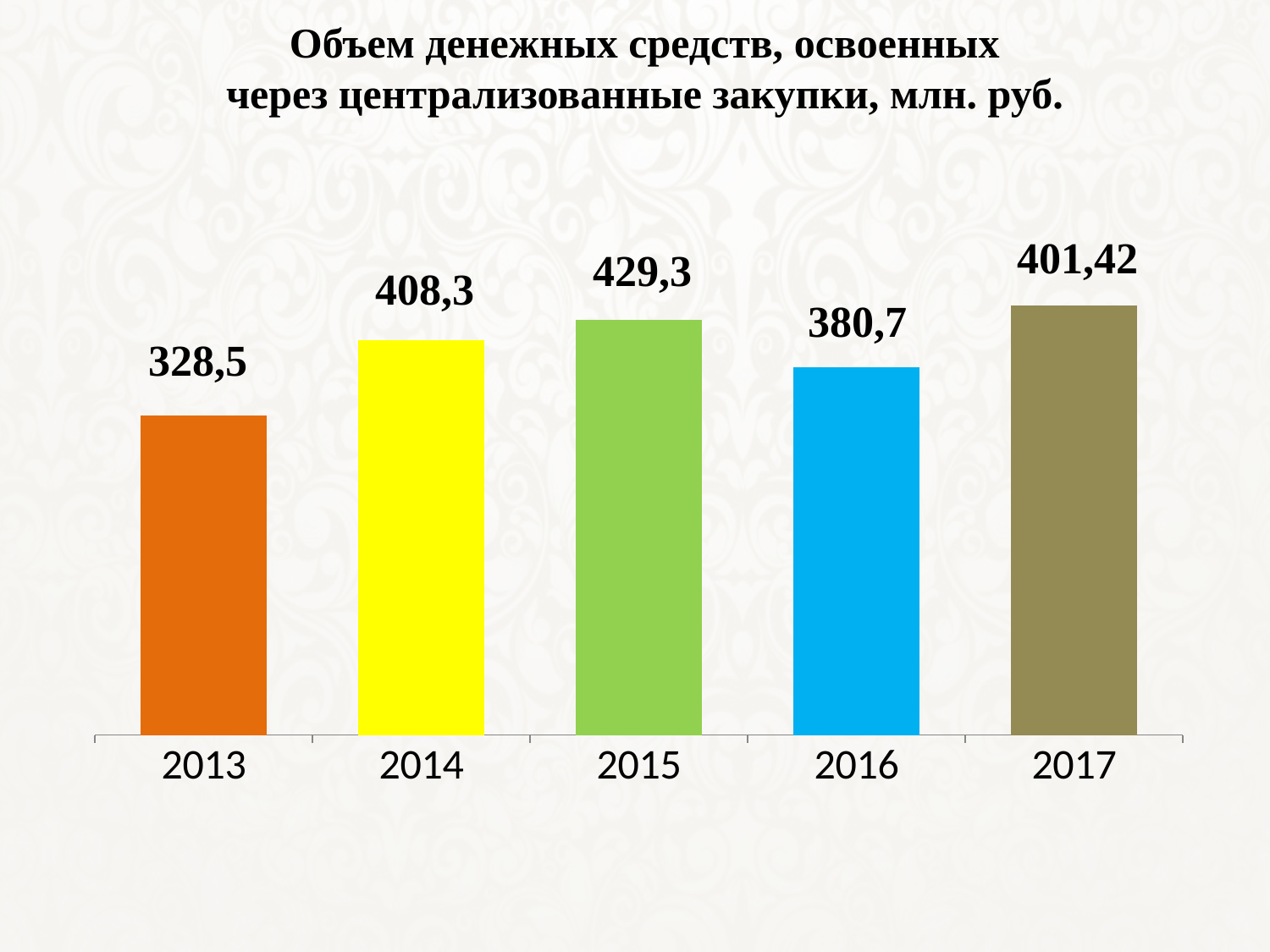
What is the value for 2016? 380,7 What kind of chart is this? bar chart What is the value for 2015? 429,3 What colour is the bar for 2016? blue What is the difference between the values for 2014 and 2016? 27,6 What is the value for 2017? 401,42 Which year has the lowest value? 2013 What is the value for 2013? 328,5 What is the difference between the values for 2015 and 2013? 100,8 How many years are shown on the x axis? 5